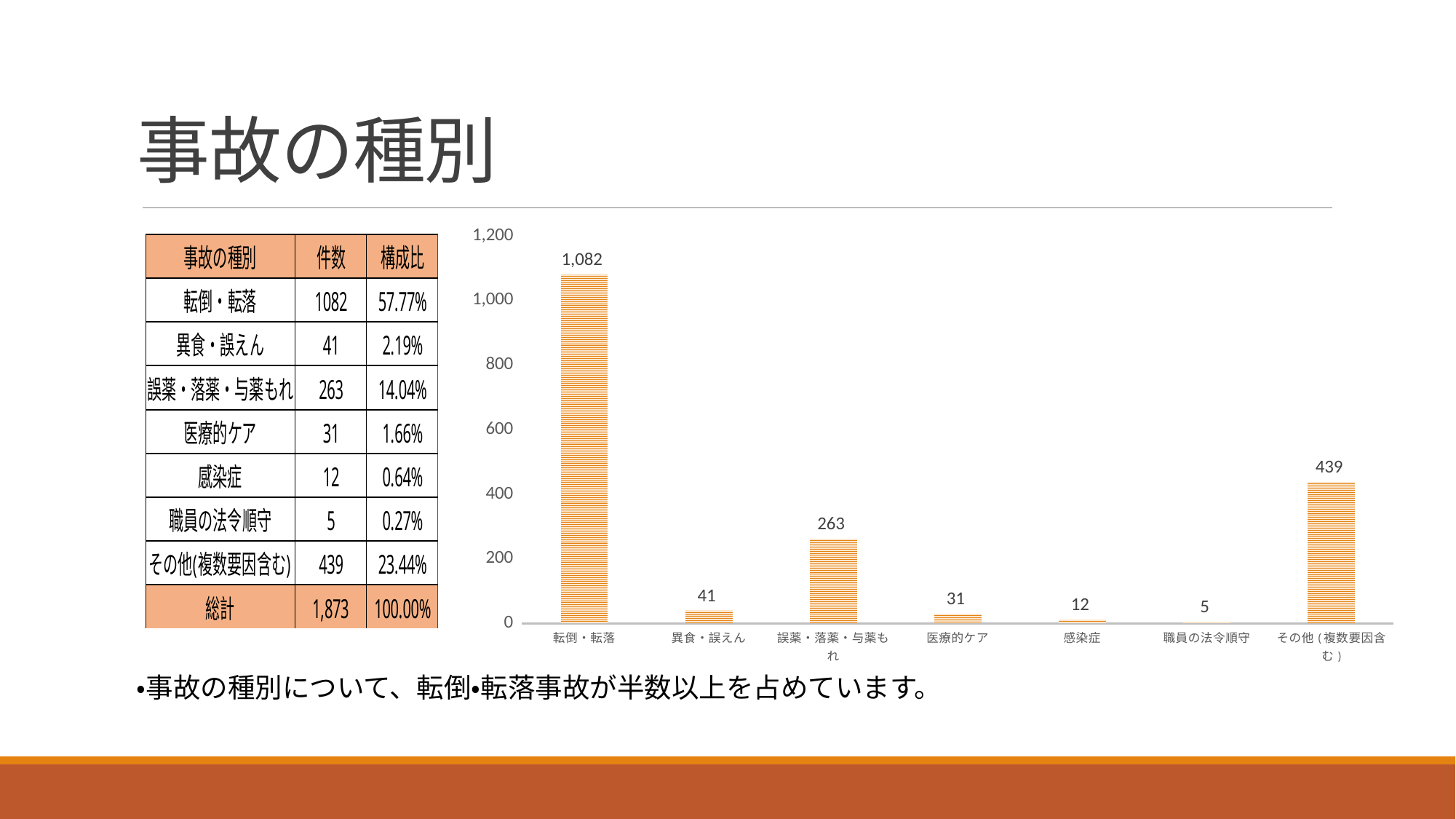
How many categories are shown in the chart? 7 What is the difference between the values for 転倒・転落 and その他(複数要因含む)? 643 Which category has the lowest value in the chart? 職員の法令順守 What kind of chart is shown on the slide? bar chart What is the value for 感染症 in the chart? 12 What is the difference between the values for 異食・誤えん and 医療的ケア? 10 Which category has the highest value in the chart? 転倒・転落 What is the value for 転倒・転落 in the chart? 1,082 What is the value for 誤薬・落薬・与薬もれ in the chart? 263 Which is larger, the value for 異食・誤えん or the value for 医療的ケア? 異食・誤えん What is the value for その他(複数要因含む) in the chart? 439 Is the value for 誤薬・落薬・与薬もれ greater or less than 200? greater